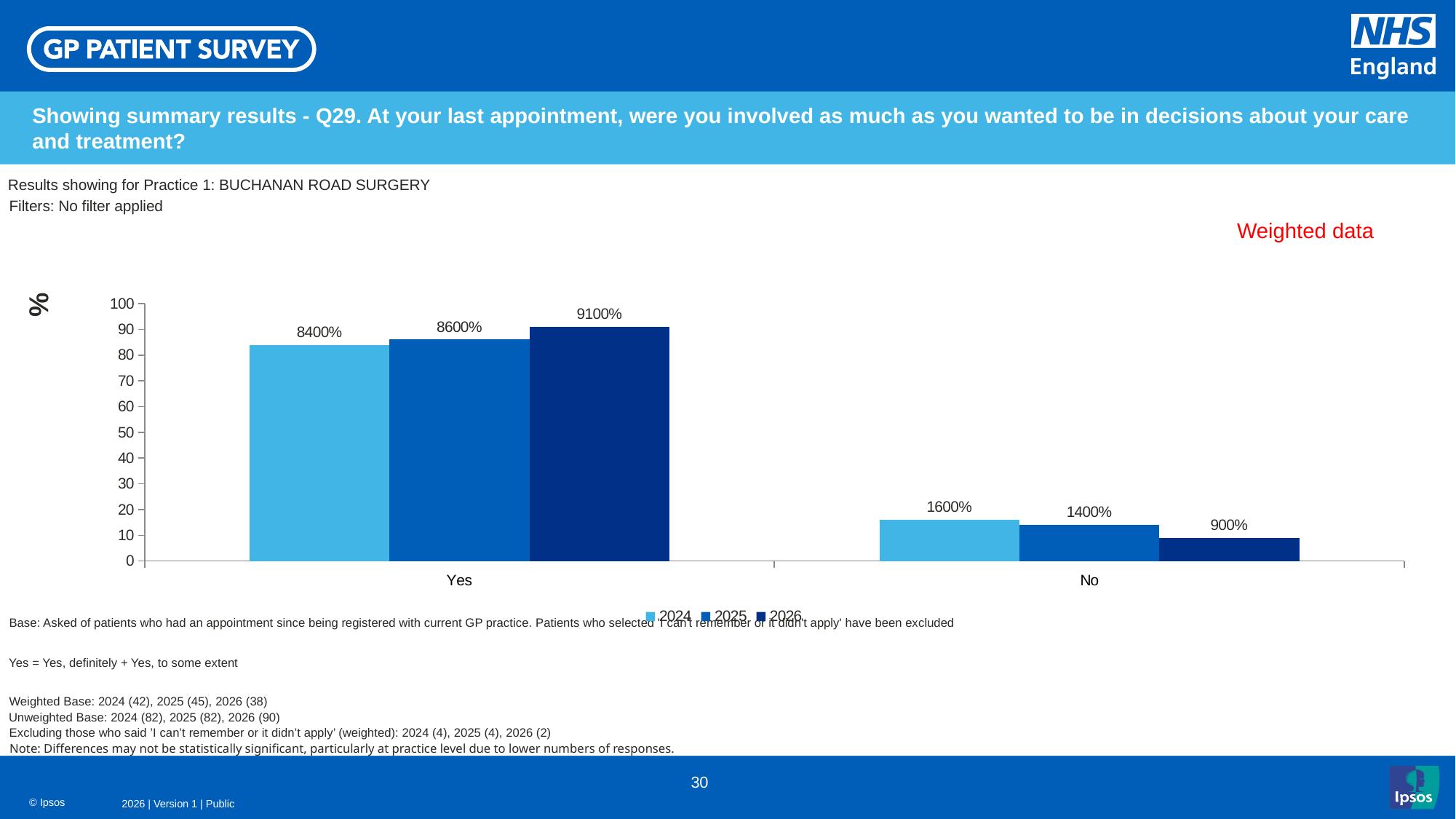
Which year has the lowest bar in the No category? 2026 What is the data label shown for 2024 in the Yes category? 8400% Which year has the highest bar in the Yes category? 2026 Which practice are the results shown for? Practice 1: BUCHANAN ROAD SURGERY How many categories are shown on the x axis? 2 What is the data label shown for 2026 in the No category? 900% What is the data label shown for 2026 in the Yes category? 9100% How many series does the legend list? 3 What kind of chart is shown on the slide? bar chart Which is larger in the No category, the 2024 bar or the 2025 bar? 2024 Is the 2025 bar in the Yes category above or below the 80 tick on the axis? above What is the data label shown for 2025 in the No category? 1400%